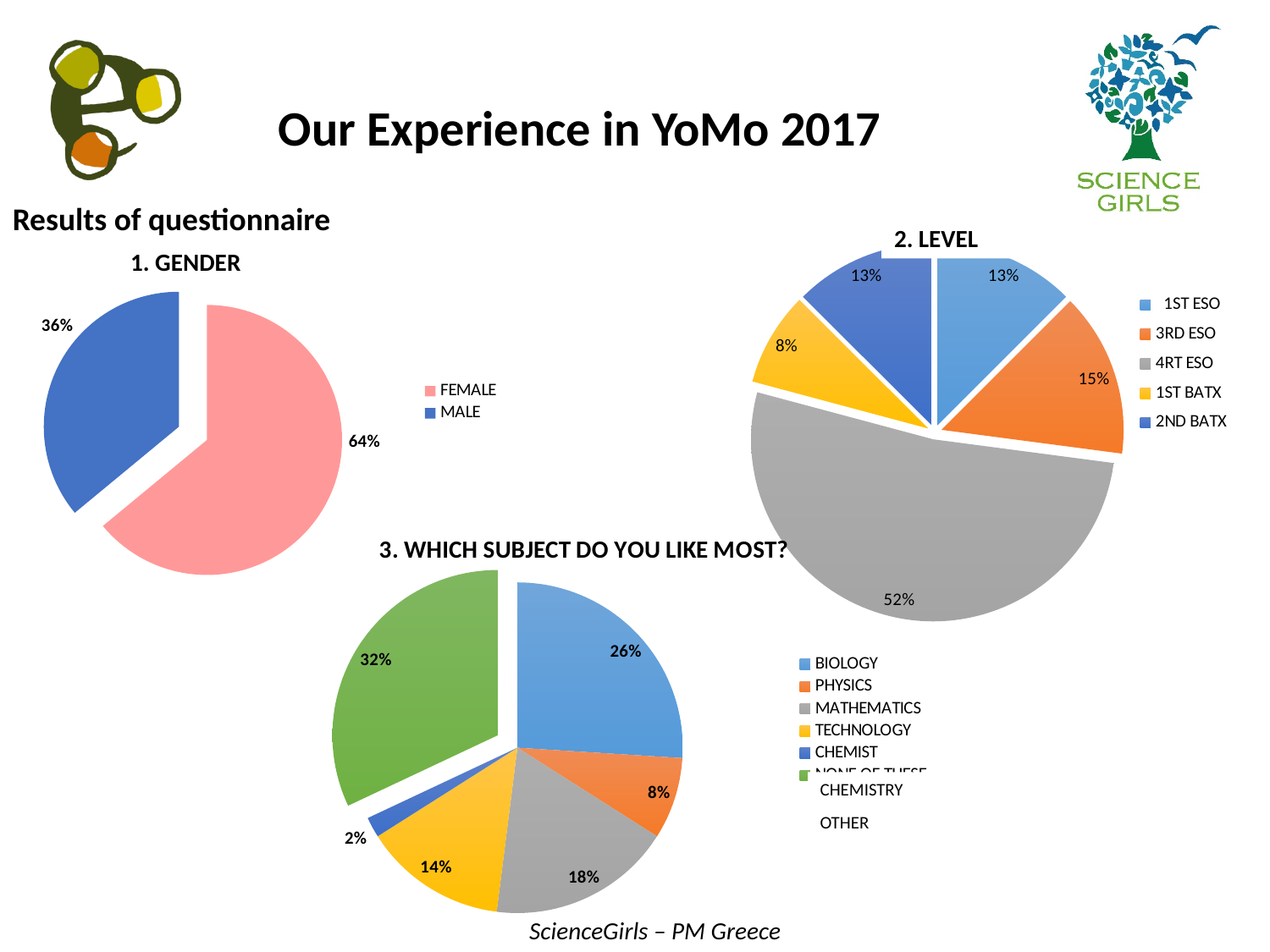
In the '2. LEVEL' pie chart, what percentage is 3RD ESO? 15% In the '3. WHICH SUBJECT DO YOU LIKE MOST?' pie chart, what percentage is BIOLOGY? 26% In the '2. LEVEL' pie chart, which level has the smallest share? 1ST BATX In the '1. GENDER' pie chart, what percentage is FEMALE? 64% In the '3. WHICH SUBJECT DO YOU LIKE MOST?' pie chart, which is larger, PHYSICS or TECHNOLOGY? TECHNOLOGY In the '1. GENDER' pie chart, what is the difference between the FEMALE and MALE shares? 28% How many categories does the legend of the '2. LEVEL' pie chart list? 5 In the '3. WHICH SUBJECT DO YOU LIKE MOST?' pie chart, what is the difference between BIOLOGY and PHYSICS? 18% In the '3. WHICH SUBJECT DO YOU LIKE MOST?' pie chart, what percentage is MATHEMATICS? 18% In the '2. LEVEL' pie chart, what percentage is 4RT ESO? 52% What type of chart is used for '1. GENDER'? Pie chart In the '1. GENDER' pie chart, what percentage is MALE? 36%